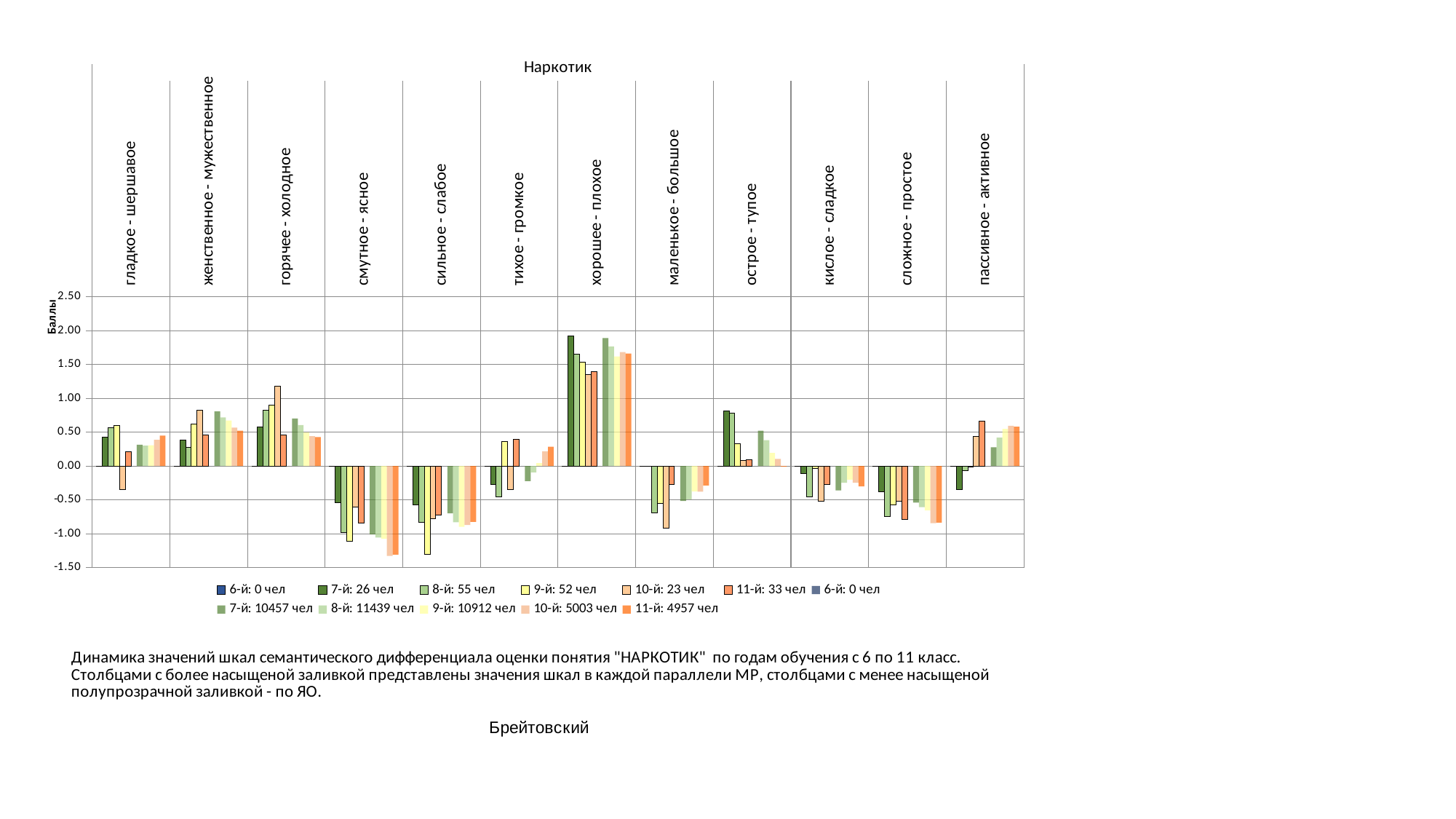
Is the value for 9-й: 52 чел in the category сильное - слабое greater or less than -1.00? less How many categories (scales) are shown along the x axis? 12 What is the title of the chart? Наркотик How many series does the legend list? 12 Is the value for 7-й: 26 чел in the category острое - тупое greater or less than 0.50? greater Is the value for 10-й: 23 чел in the category горячее - холодное greater or less than 1.00? greater In the category хорошее - плохое, which is larger: the value for 7-й: 26 чел or the value for 10-й: 23 чел? 7-й: 26 чел Which category has the highest values on the chart? хорошее - плохое What is the label of the vertical axis? Баллы What kind of chart is shown on the slide? bar chart